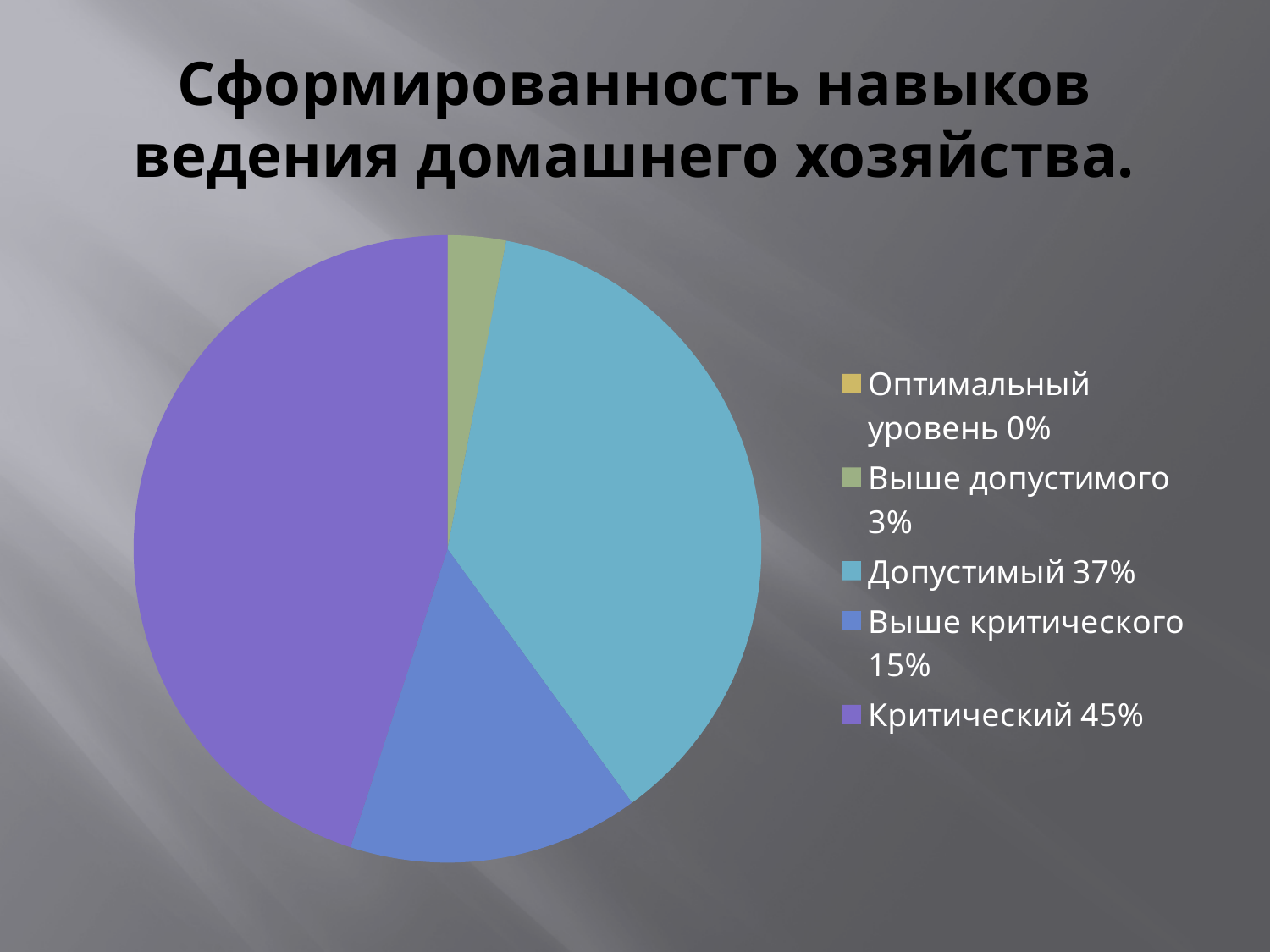
What kind of chart is shown on the slide? Pie chart What is the share for Выше критического? 15% How many categories does the legend list? 5 Which category has the largest share of the pie? Критический What is the share for Допустимый? 37% What is the share for Выше допустимого? 3% Which category has the smallest share of the pie? Оптимальный уровень Which is larger, the share for Допустимый or the share for Выше критического? Допустимый What is the share for Критический? 45% What is the title of the chart? Сформированность навыков ведения домашнего хозяйства. What is the share for Оптимальный уровень? 0% What is the difference between the shares for Критический and Допустимый? 8%